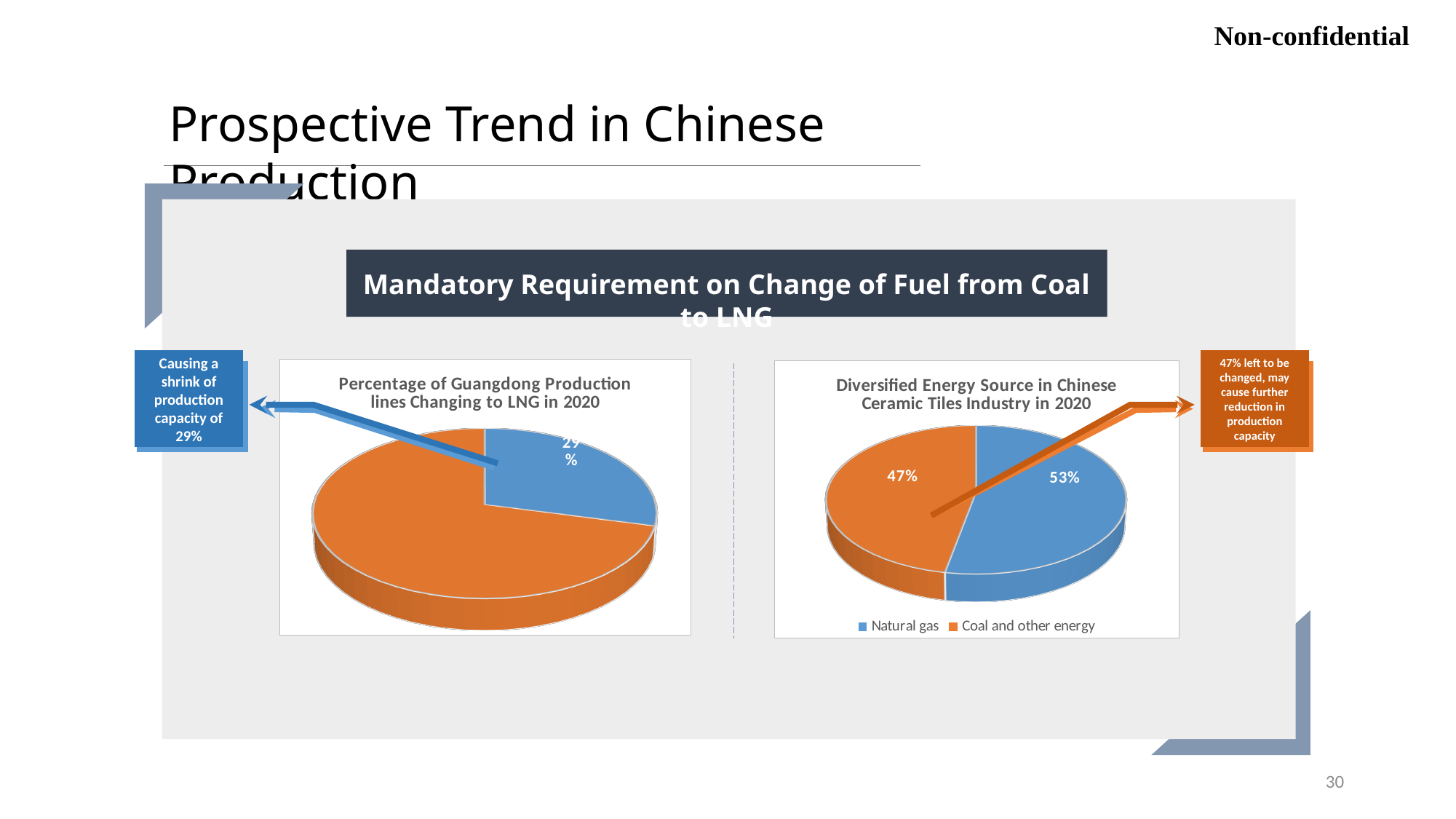
What kind of chart is the left chart, 'Percentage of Guangdong Production lines Changing to LNG in 2020'? Pie chart On the right chart, 'Diversified Energy Source in Chinese Ceramic Tiles Industry in 2020', what share is Natural gas? 53% On the left chart, 'Percentage of Guangdong Production lines Changing to LNG in 2020', which slice is larger, the blue one or the orange one? The orange one On the right chart, 'Diversified Energy Source in Chinese Ceramic Tiles Industry in 2020', which energy source has the largest share? Natural gas On the right chart, 'Diversified Energy Source in Chinese Ceramic Tiles Industry in 2020', by how many percentage points does Natural gas exceed Coal and other energy? 6 percentage points On the right chart, 'Diversified Energy Source in Chinese Ceramic Tiles Industry in 2020', which energy source has the smallest share? Coal and other energy On the left chart, 'Percentage of Guangdong Production lines Changing to LNG in 2020', what value is printed on the blue slice? 29% On the right chart, 'Diversified Energy Source in Chinese Ceramic Tiles Industry in 2020', what share is Coal and other energy? 47% What kind of chart is the right chart, 'Diversified Energy Source in Chinese Ceramic Tiles Industry in 2020'? Pie chart On the right chart, 'Diversified Energy Source in Chinese Ceramic Tiles Industry in 2020', how many entries does the legend list? 2 How many slices does the left chart, 'Percentage of Guangdong Production lines Changing to LNG in 2020', have? 2 On the right chart, which colour represents Coal and other energy? Orange